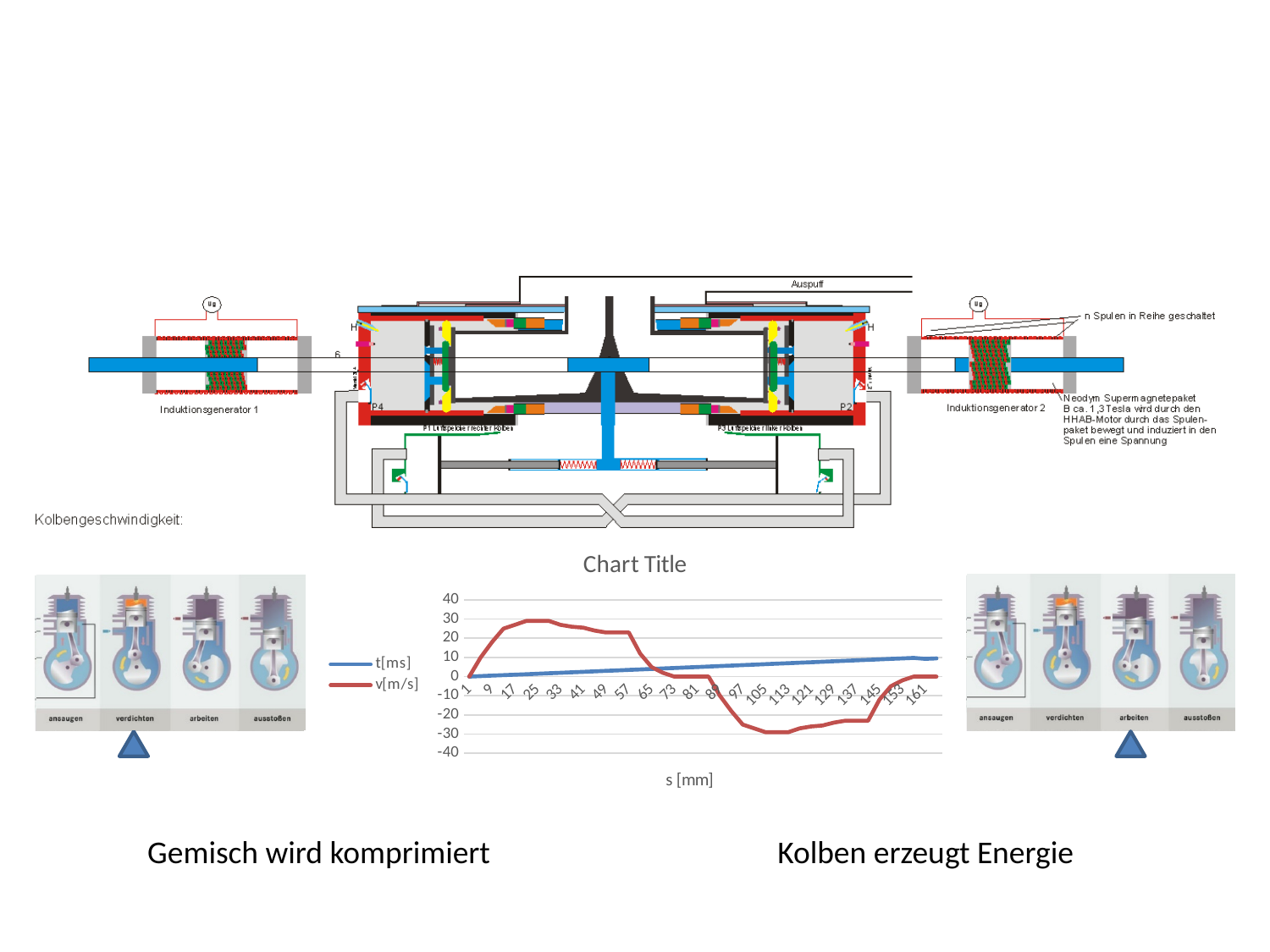
Is the value of t[ms] at s = 81 greater or less than 10? less What kind of chart is shown on the slide? line chart Does the t[ms] series rise or fall as s increases along the x axis? rise At s = 25, which series has the larger value, t[ms] or v[m/s]? v[m/s] What is the x-axis title of the chart? s [mm] How many tick labels are shown on the x axis of the chart? 21 Is the value of v[m/s] at s = 57 greater or less than 10? greater Is the value of v[m/s] at s = 105 greater or less than -20? less At s = 113, which series has the larger value, t[ms] or v[m/s]? t[ms] What are the two series named in the chart legend? t[ms] and v[m/s] How many series does the chart legend list? 2